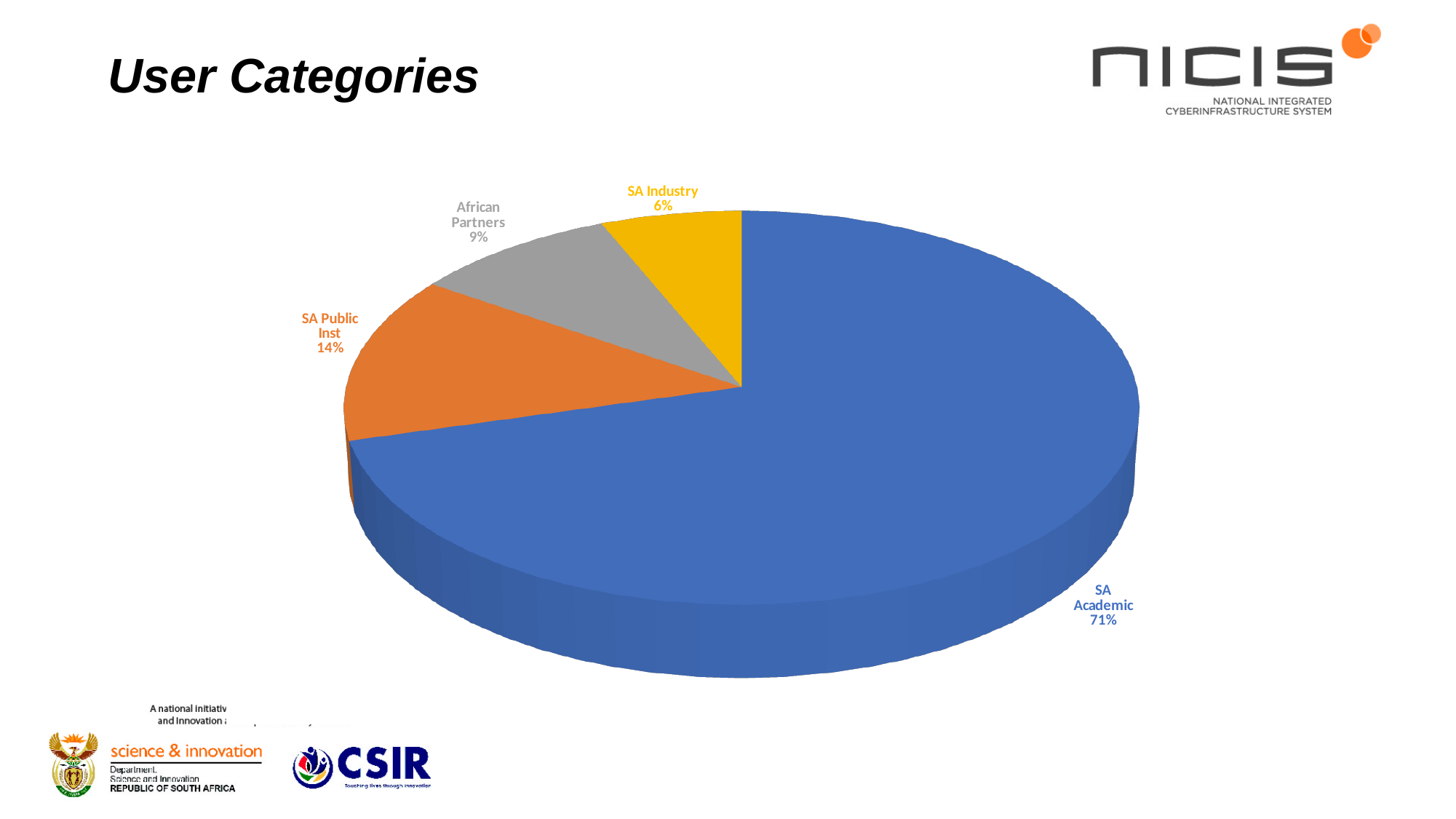
What percentage is shown for African Partners? 9% Which is larger, the share for SA Public Inst or the share for African Partners? SA Public Inst What is the difference in percentage points between African Partners and SA Industry? 3 How many user categories are shown in the pie chart? 4 What colour is the SA Public Inst slice? Orange What type of chart is shown on the slide? Pie chart Which user category has the largest slice of the pie? SA Academic What is the difference in percentage points between SA Academic and SA Public Inst? 57 What percentage is shown for SA Industry? 6% What percentage is shown for SA Public Inst? 14% What share of users does SA Academic represent? 71% Which user category has the smallest slice of the pie? SA Industry